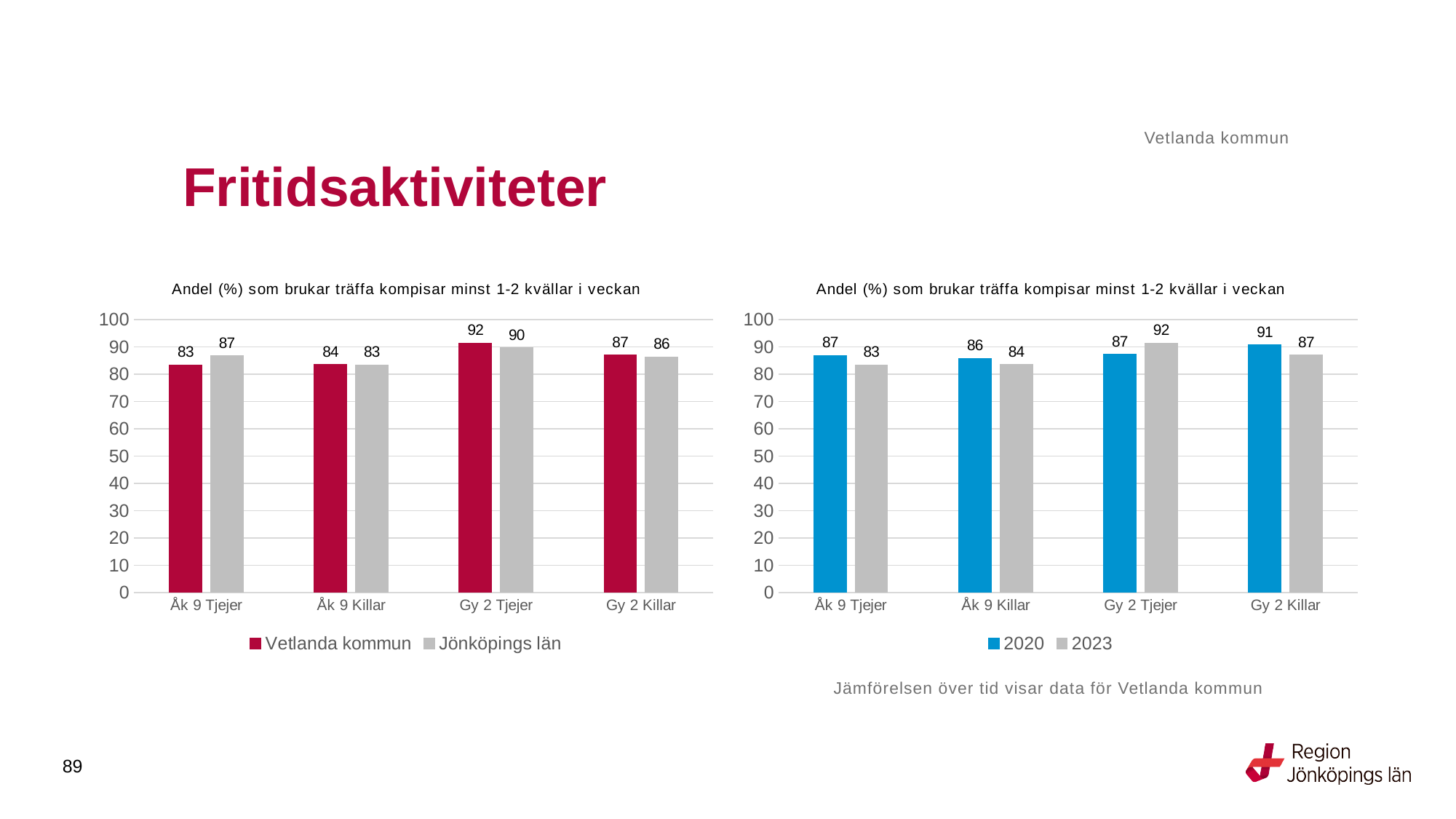
In the left chart, which category has the lowest value for Jönköpings län? Åk 9 Killar In the right chart, what is the difference between 2023 and 2020 for Gy 2 Tjejer? 5 In the left chart, which category has the highest value for Vetlanda kommun? Gy 2 Tjejer In the left chart, how many series does the legend list? 2 In the right chart, what is the value for 2020 for Gy 2 Killar? 91 In the right chart, how many categories are shown on the x axis? 4 In the right chart, what is the value for 2023 for Gy 2 Tjejer? 92 In the left chart, what is the value for Vetlanda kommun for Gy 2 Tjejer? 92 In the right chart, which is larger for Åk 9 Tjejer, 2020 or 2023? 2020 What kind of chart is the right chart? Bar chart In the left chart, what is the value for Jönköpings län for Åk 9 Tjejer? 87 In the left chart, what is the difference between Jönköpings län and Vetlanda kommun for Åk 9 Tjejer? 4